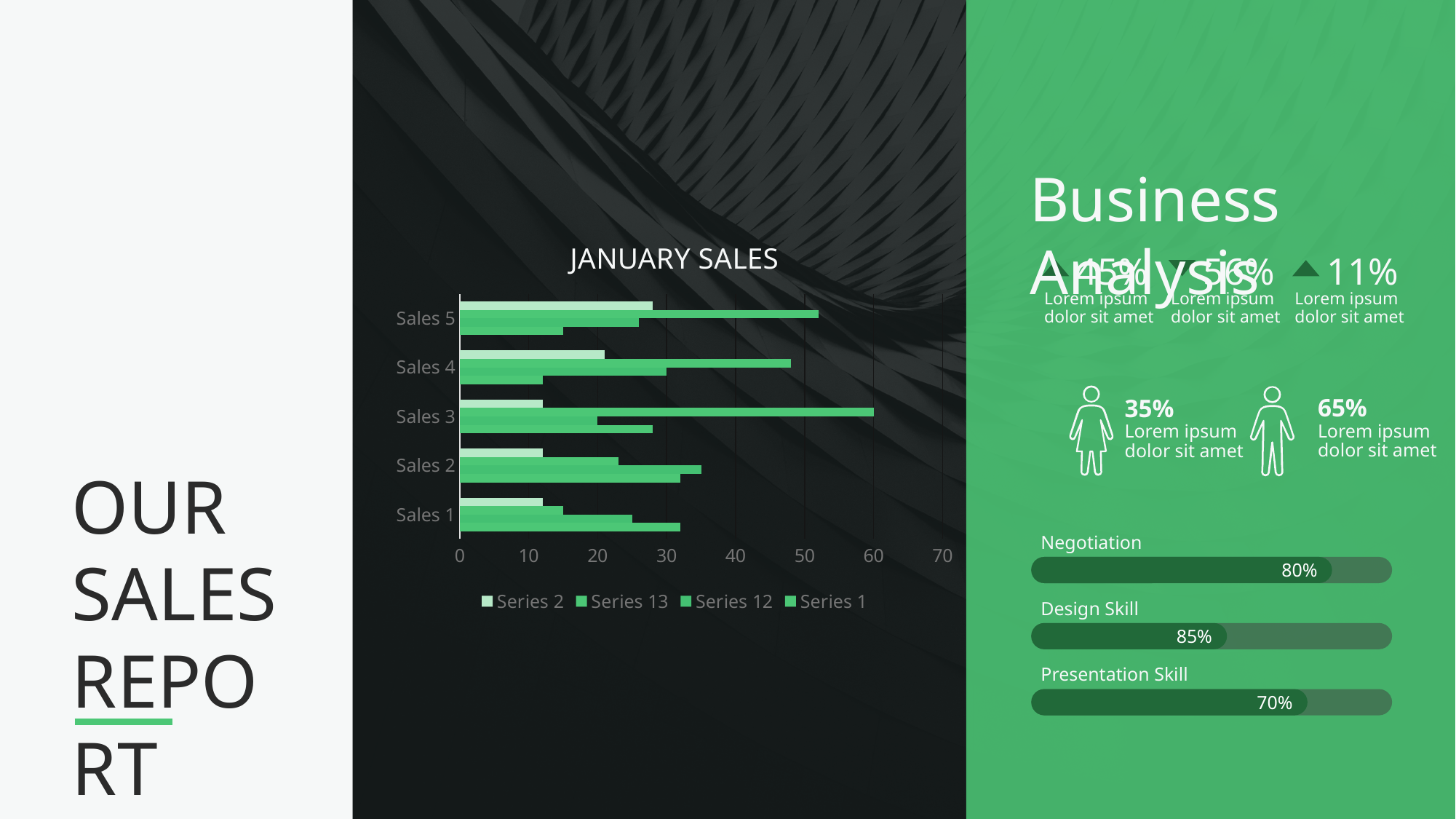
In the JANUARY SALES chart, is the longest bar for Sales 2 greater or less than 50? less In the JANUARY SALES chart, is the longest bar for Sales 1 greater or less than 40? less What is the title of the chart on the dark panel? JANUARY SALES In the JANUARY SALES chart, which category contains the longest bar overall? Sales 3 How many categories are shown on the vertical axis of the JANUARY SALES chart? 5 In the JANUARY SALES chart, is the longest bar for Sales 5 greater or less than 40? greater What is the highest tick value shown on the horizontal axis of the JANUARY SALES chart? 70 How many series does the legend of the JANUARY SALES chart list? 4 What are the legend entries of the JANUARY SALES chart? Series 2, Series 13, Series 12, Series 1 In the JANUARY SALES chart, which category has the longer longest bar, Sales 3 or Sales 1? Sales 3 What kind of chart is shown under the title JANUARY SALES? Bar chart